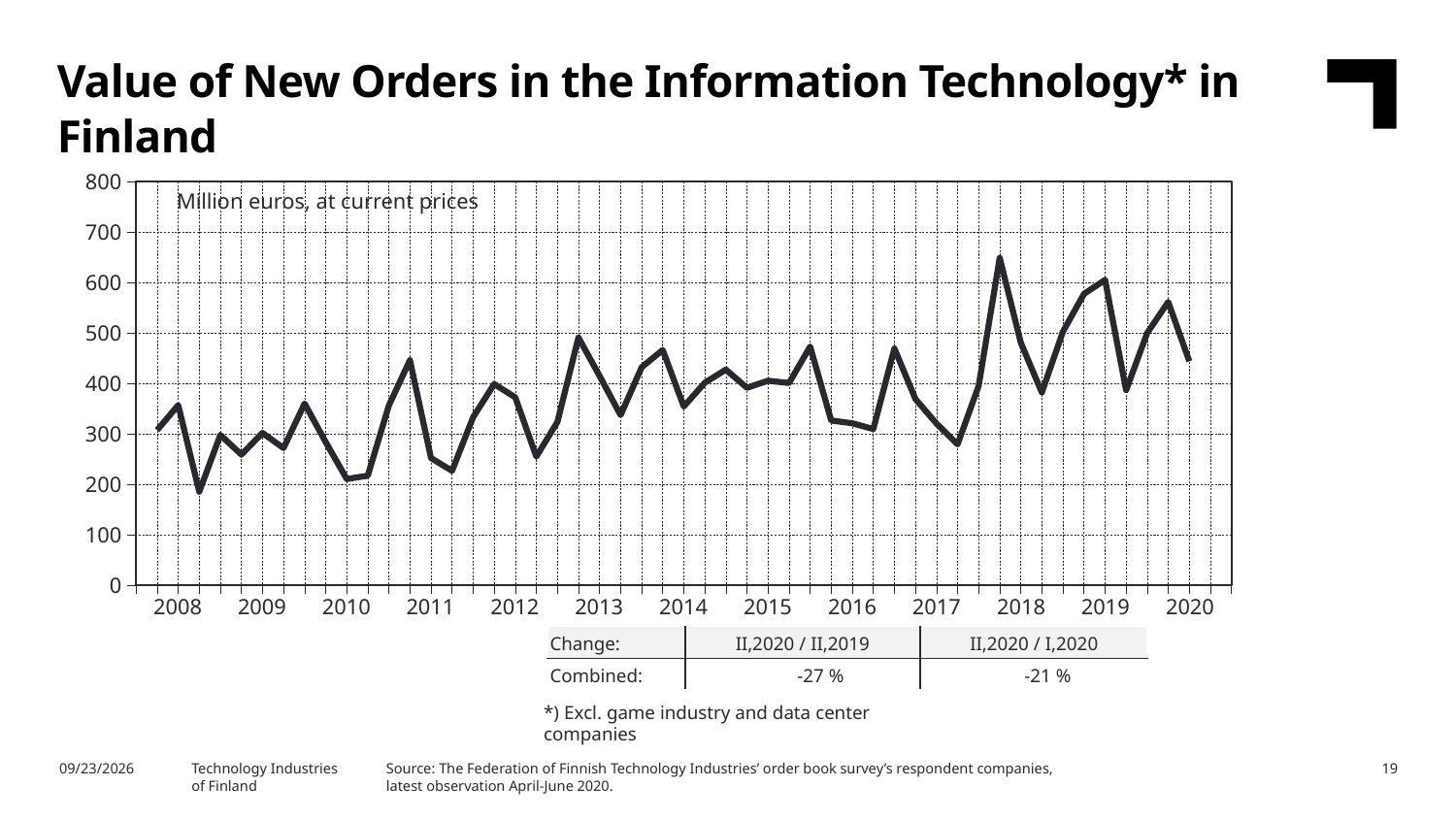
What unit is stated for the values in the chart? Million euros, at current prices Is the last plotted value in 2020 greater or less than 400? greater What kind of chart is shown on the slide? line chart How many year labels are shown along the x axis of the chart? 13 Is the peak value in 2018 greater or less than 600? greater What is the highest value shown on the vertical axis of the chart? 800 Is the lowest value in 2008 greater or less than 250? less What is the combined change for II,2020 / II,2019 shown below the chart? -27 % Is the peak in 2018 higher or lower than the peak in 2013? higher In which year does the line reach its lowest point? 2008 In which year does the line reach its highest peak? 2018